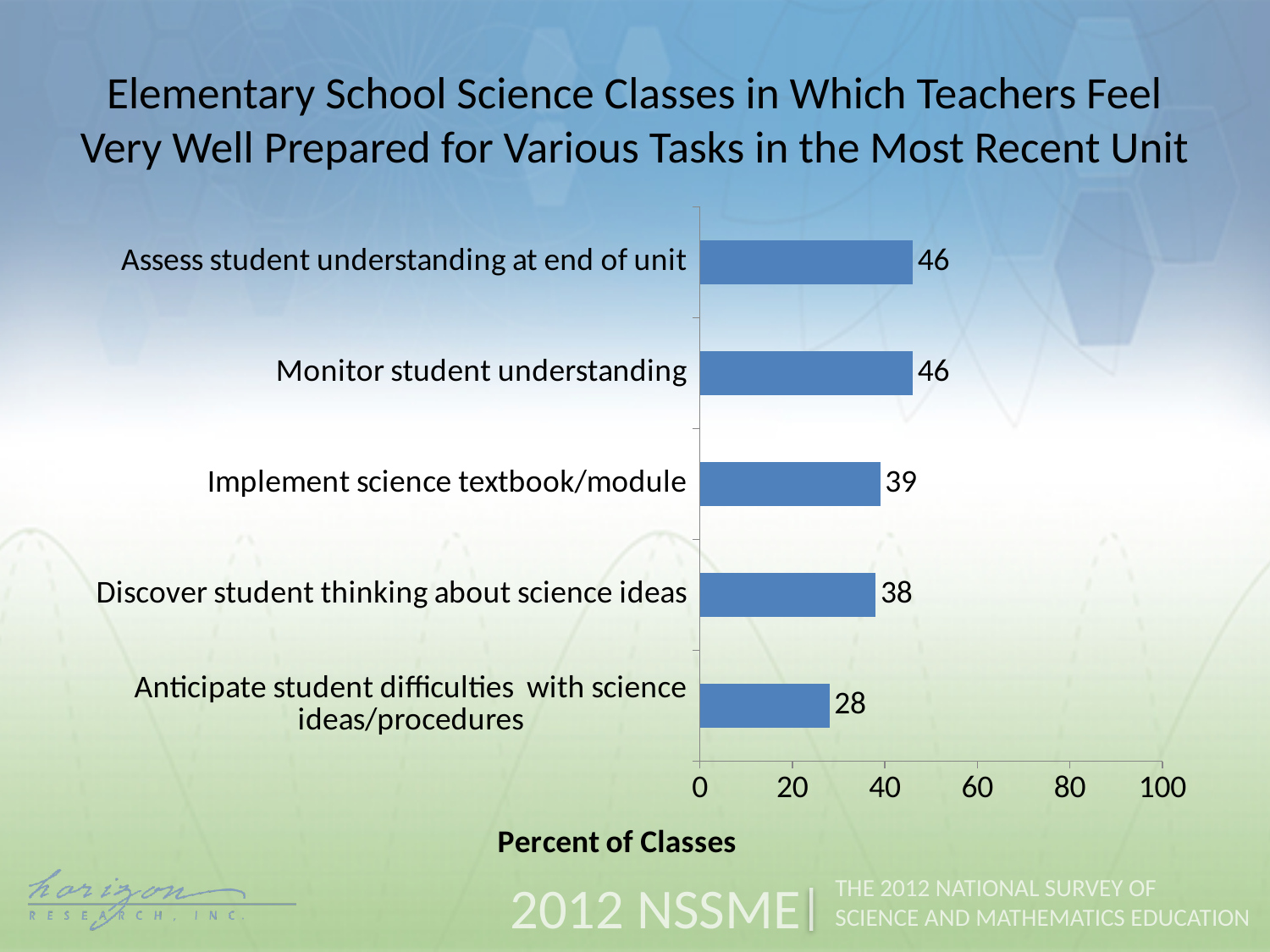
What is the value for "Discover student thinking about science ideas"? 38 What is the value for "Implement science textbook/module"? 39 Which category has the lowest value? Anticipate student difficulties with science ideas/procedures What is the value for "Anticipate student difficulties with science ideas/procedures"? 28 What is the value for "Monitor student understanding"? 46 Which is larger, the value for "Implement science textbook/module" or the value for "Anticipate student difficulties with science ideas/procedures"? Implement science textbook/module What is the difference between the values for "Assess student understanding at end of unit" and "Anticipate student difficulties with science ideas/procedures"? 18 What kind of chart is shown on the slide? bar chart What is the difference between the values for "Implement science textbook/module" and "Discover student thinking about science ideas"? 1 What is the label of the horizontal axis? Percent of Classes How many categories are shown in the chart? 5 Is the value for "Monitor student understanding" greater or less than 40? greater